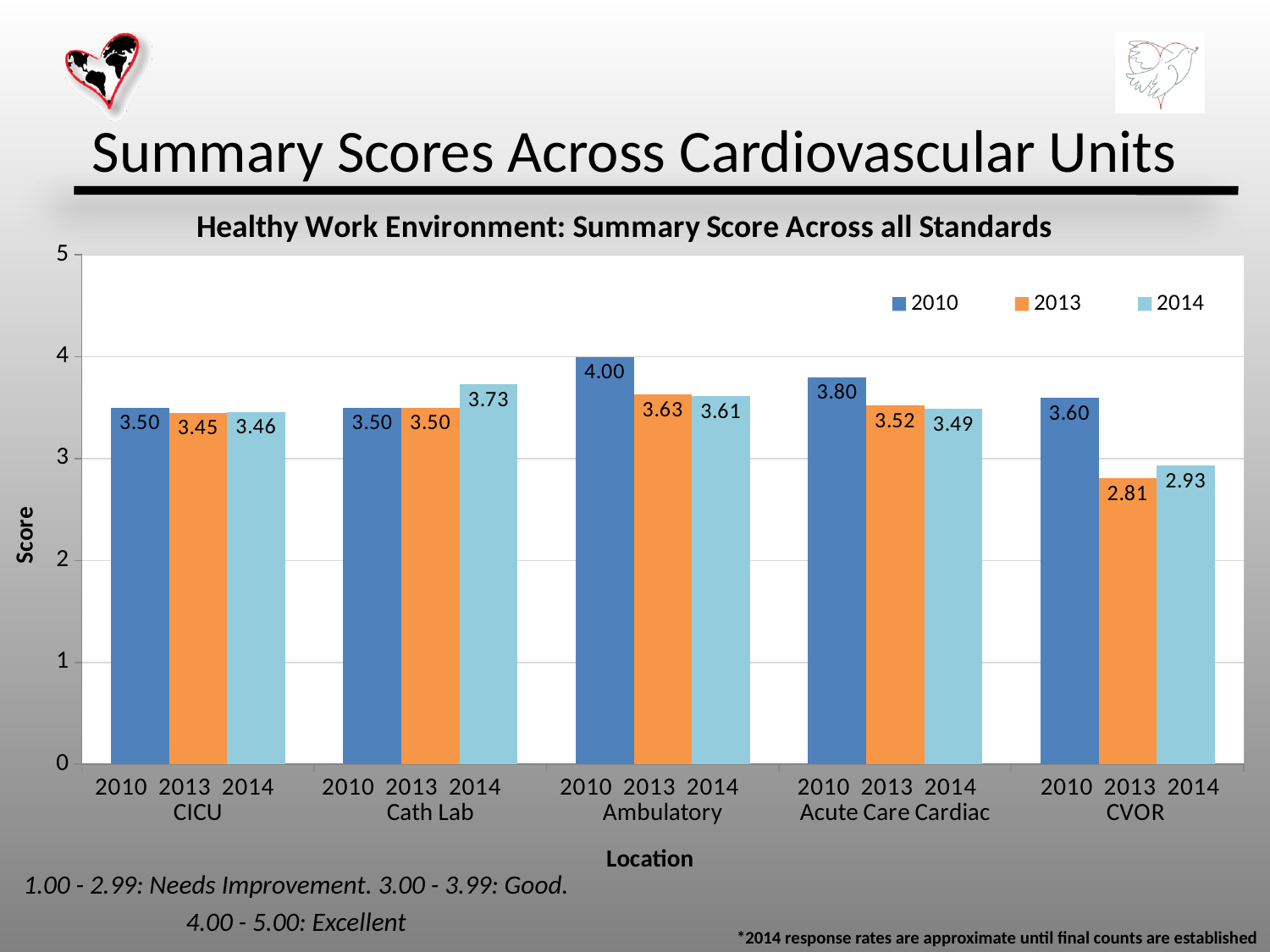
Which location has the lowest 2014 score? CVOR What is the 2010 score for Ambulatory? 4.00 Is the 2013 score for CVOR greater or less than 3? less What is the difference between the 2010 and 2013 scores for CVOR? 0.79 What is the title of the chart? Healthy Work Environment: Summary Score Across all Standards What kind of chart is shown? bar chart How many series does the legend list? 3 Which is larger, the 2014 score for Cath Lab or the 2014 score for Ambulatory? Cath Lab What is the 2013 score for CVOR? 2.81 How many locations are shown on the x axis? 5 What is the 2014 score for Cath Lab? 3.73 Which location has the highest 2010 score? Ambulatory